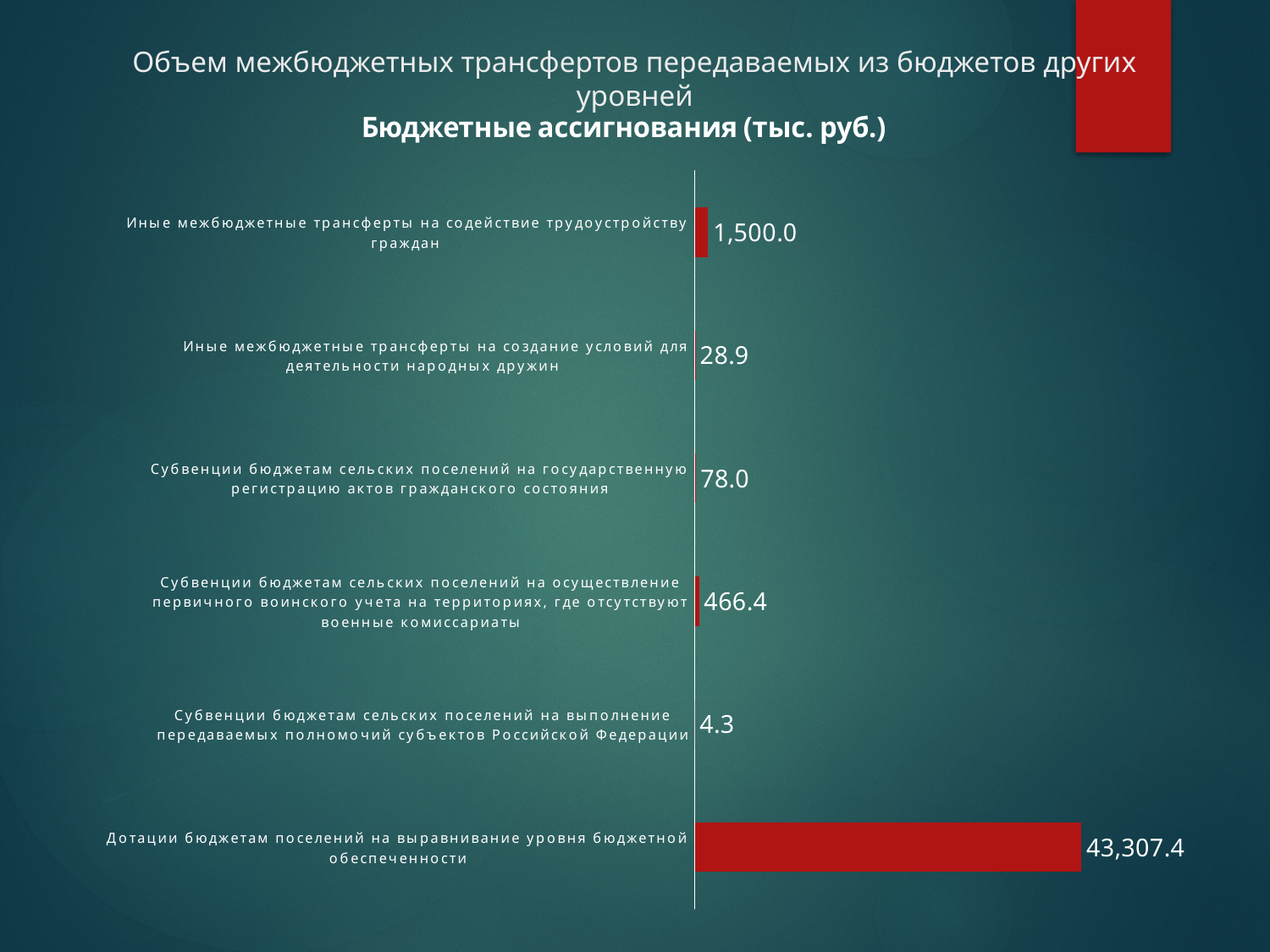
Which category has the highest value? Дотации бюджетам поселений на выравнивание уровня бюджетной обеспеченности What is the difference between the value for "Субвенции бюджетам сельских поселений на государственную регистрацию актов гражданского состояния" and the value for "Иные межбюджетные трансферты на создание условий для деятельности народных дружин"? 49.1 What is the value for "Субвенции бюджетам сельских поселений на государственную регистрацию актов гражданского состояния"? 78.0 What is the value for "Иные межбюджетные трансферты на создание условий для деятельности народных дружин"? 28.9 Which category has the lowest value? Субвенции бюджетам сельских поселений на выполнение передаваемых полномочий субъектов Российской Федерации Which is larger: the value for "Иные межбюджетные трансферты на содействие трудоустройству граждан" or the value for "Субвенции бюджетам сельских поселений на осуществление первичного воинского учета на территориях, где отсутствуют военные комиссариаты"? Иные межбюджетные трансферты на содействие трудоустройству граждан What is the value for "Дотации бюджетам поселений на выравнивание уровня бюджетной обеспеченности"? 43,307.4 What is the value for "Иные межбюджетные трансферты на содействие трудоустройству граждан"? 1,500.0 What is the difference between the value for "Дотации бюджетам поселений на выравнивание уровня бюджетной обеспеченности" and the value for "Иные межбюджетные трансферты на содействие трудоустройству граждан"? 41,807.4 What is the value for "Субвенции бюджетам сельских поселений на осуществление первичного воинского учета на территориях, где отсутствуют военные комиссариаты"? 466.4 What kind of chart is shown on the slide? Bar chart How many categories are shown in the chart? 6